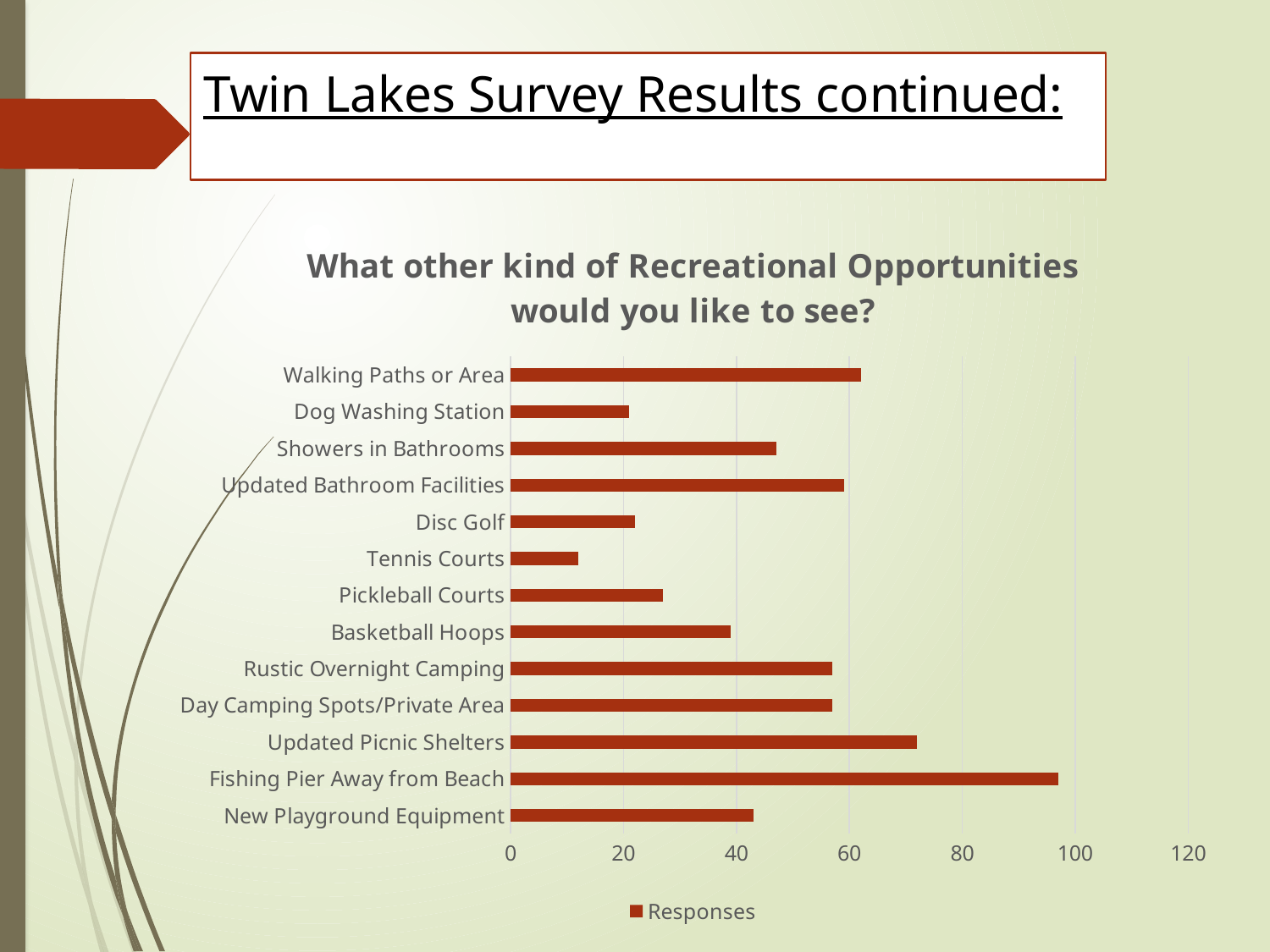
Which has more responses, Basketball Hoops or Pickleball Courts? Basketball Hoops Is the value for Tennis Courts greater or less than 20? less Is the value for Showers in Bathrooms greater or less than 40? greater Which category has the lowest number of responses? Tennis Courts How many categories are plotted in the chart? 13 Is the value for Updated Picnic Shelters greater or less than 60? greater Which has more responses, Showers in Bathrooms or Dog Washing Station? Showers in Bathrooms What is the name of the series shown in the legend? Responses What kind of chart is shown on the slide? bar chart How many series does the legend list? 1 Which category has the highest number of responses? Fishing Pier Away from Beach